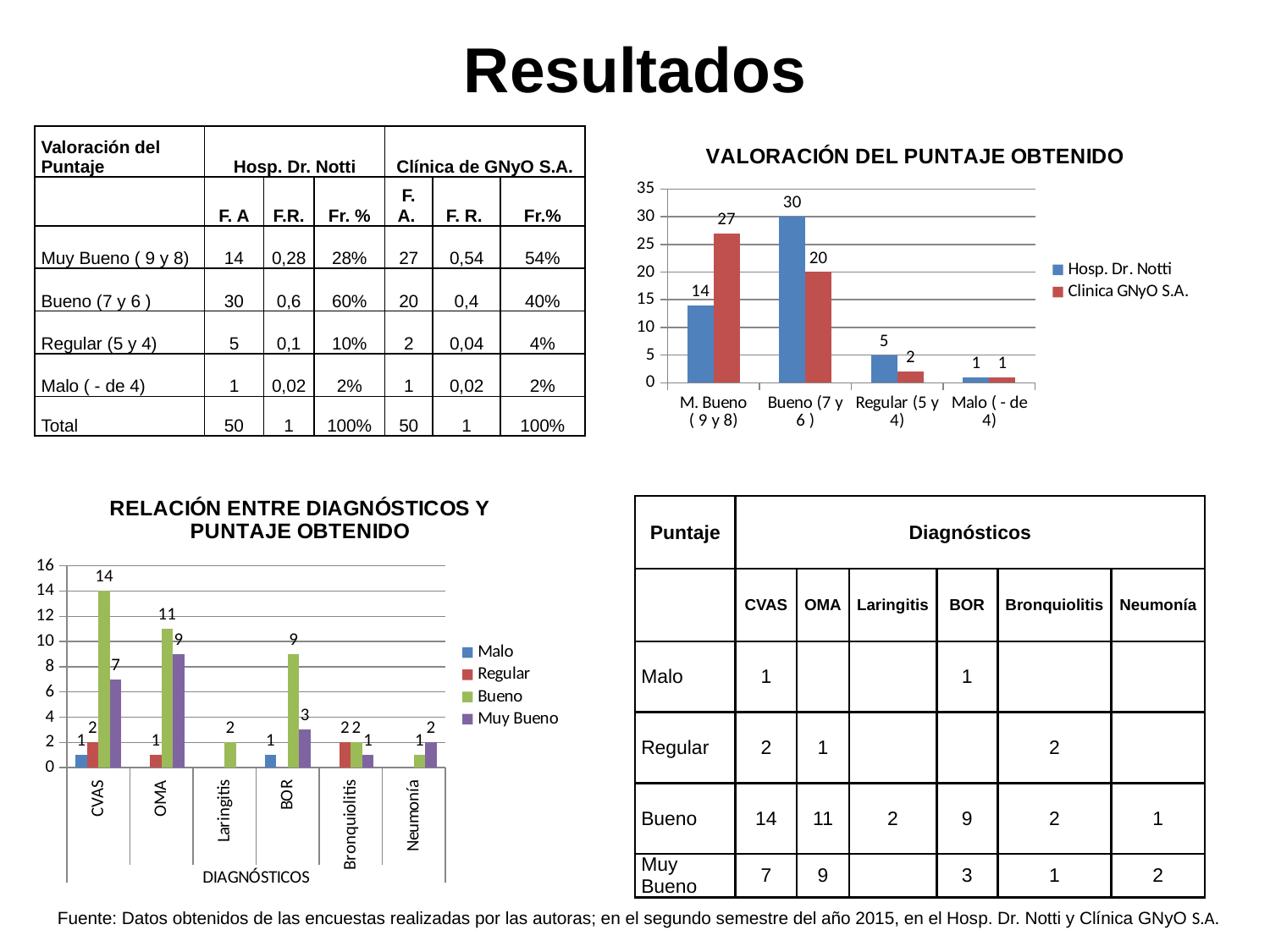
In the chart 'VALORACIÓN DEL PUNTAJE OBTENIDO', what is the value for Hosp. Dr. Notti in the category Bueno (7 y 6)? 30 In the chart 'RELACIÓN ENTRE DIAGNÓSTICOS Y PUNTAJE OBTENIDO', how many diagnosis categories are shown on the x axis? 6 In the chart 'RELACIÓN ENTRE DIAGNÓSTICOS Y PUNTAJE OBTENIDO', what is the value of Muy Bueno for OMA? 9 In the chart 'RELACIÓN ENTRE DIAGNÓSTICOS Y PUNTAJE OBTENIDO', what is the difference between the Bueno values for CVAS and BOR? 5 In the chart 'VALORACIÓN DEL PUNTAJE OBTENIDO', which category has the highest value for Clinica GNyO S.A.? M. Bueno (9 y 8) In the chart 'VALORACIÓN DEL PUNTAJE OBTENIDO', what is the difference between Hosp. Dr. Notti and Clinica GNyO S.A. in the category Bueno (7 y 6)? 10 In the chart 'VALORACIÓN DEL PUNTAJE OBTENIDO', which is larger in the category Regular (5 y 4): Hosp. Dr. Notti or Clinica GNyO S.A.? Hosp. Dr. Notti In the chart 'RELACIÓN ENTRE DIAGNÓSTICOS Y PUNTAJE OBTENIDO', how many series does the legend list? 4 In the chart 'RELACIÓN ENTRE DIAGNÓSTICOS Y PUNTAJE OBTENIDO', what is the value of Bueno for CVAS? 14 In the chart 'VALORACIÓN DEL PUNTAJE OBTENIDO', what is the value for Clinica GNyO S.A. in the category M. Bueno (9 y 8)? 27 What kind of chart is 'VALORACIÓN DEL PUNTAJE OBTENIDO'? Bar chart How many series does the legend of the chart 'VALORACIÓN DEL PUNTAJE OBTENIDO' list? 2